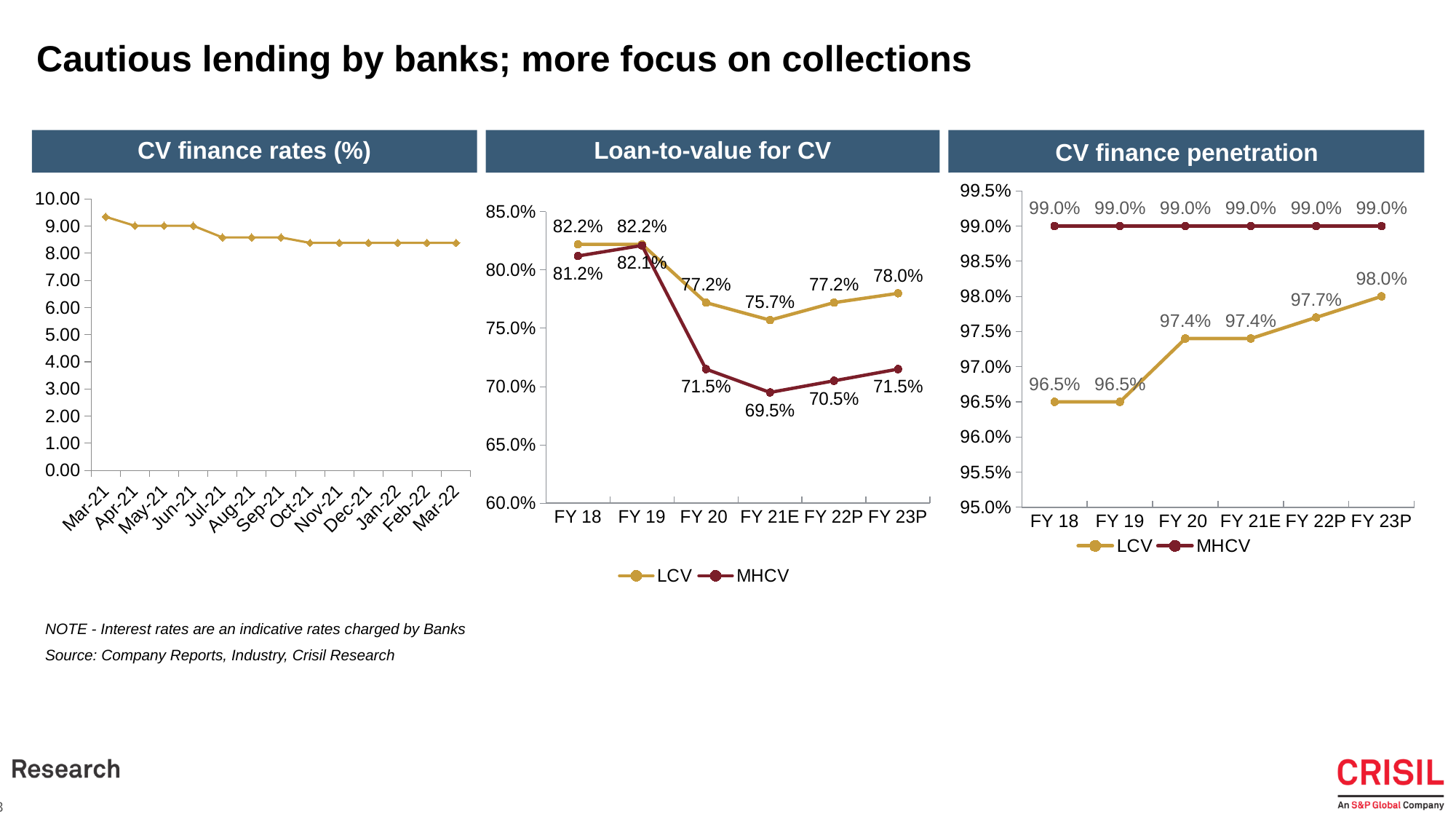
In the CV finance penetration chart, in which year is the LCV value highest? FY 23P In the Loan-to-value for CV chart, what is the difference between the LCV and MHCV values for FY 20? 5.7 percentage points In the Loan-to-value for CV chart, what is the LCV value for FY 23P? 78.0% In the Loan-to-value for CV chart, in which year is the LCV value lowest? FY 21E In the CV finance rates (%) chart, is the value for Mar-21 greater or less than 9.00? greater Do the values in the CV finance rates (%) chart rise or fall from Mar-21 to Mar-22? fall How many months are plotted in the CV finance rates (%) chart? 13 In the CV finance rates (%) chart, is the value for Mar-22 greater or less than 9.00? less In the Loan-to-value for CV chart, which series has the higher value in FY 18, LCV or MHCV? LCV In the CV finance penetration chart, what is the LCV value for FY 22P? 97.7% In the Loan-to-value for CV chart, what is the MHCV value for FY 21E? 69.5% How many series does the legend of the Loan-to-value for CV chart list? 2